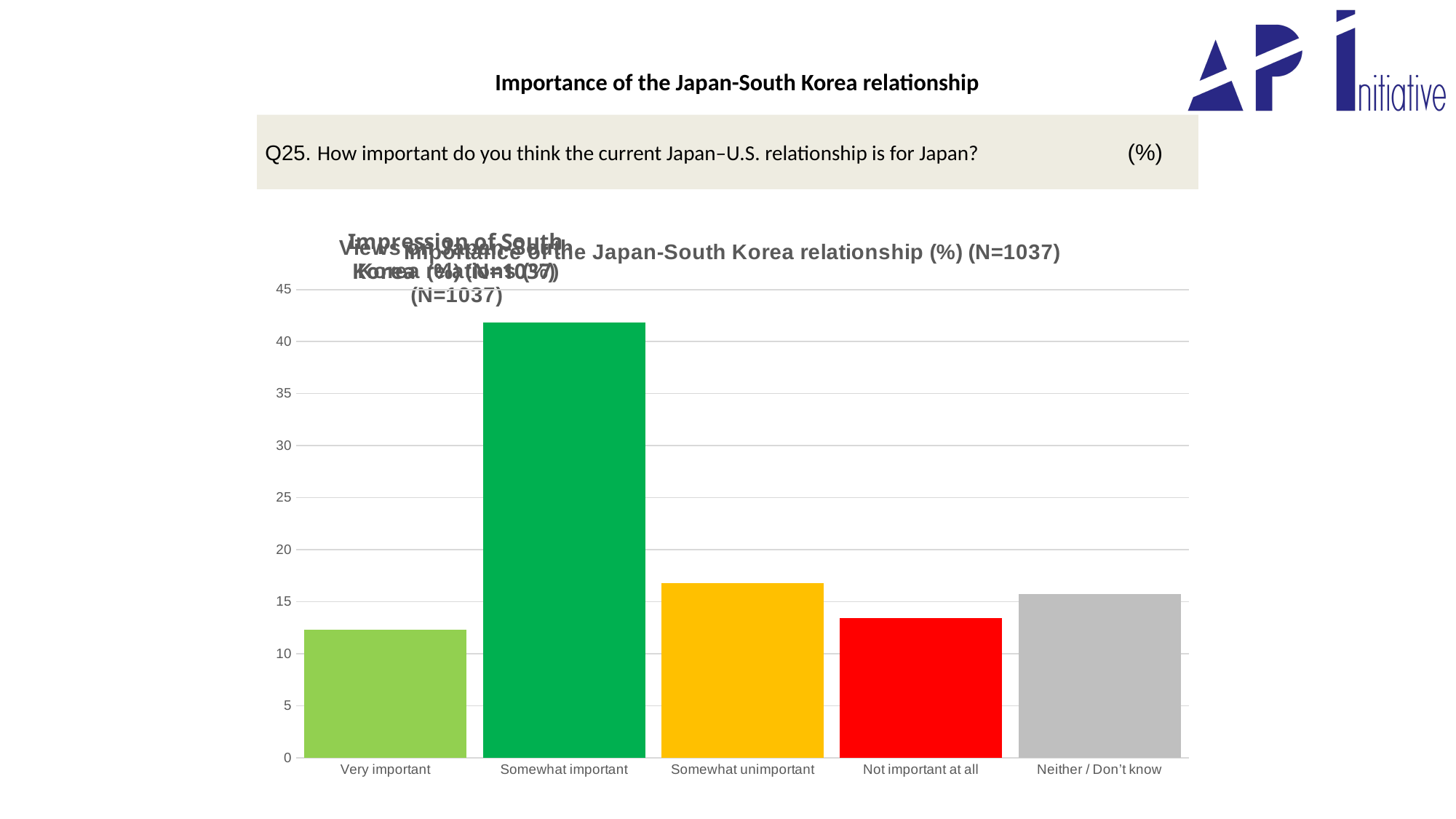
Is the value for Somewhat important greater or less than 40? greater Which category has the highest value in the chart? Somewhat important Is the value for Neither / Don't know greater or less than 20? less Which is larger, the value for Somewhat unimportant or the value for Not important at all? Somewhat unimportant Is the value for Very important greater or less than 10? greater Which is larger, the value for Somewhat important or the value for Neither / Don't know? Somewhat important How many categories are shown on the x axis of the chart? 5 What kind of chart is shown on the slide? bar chart What colour is the bar for Somewhat important? green